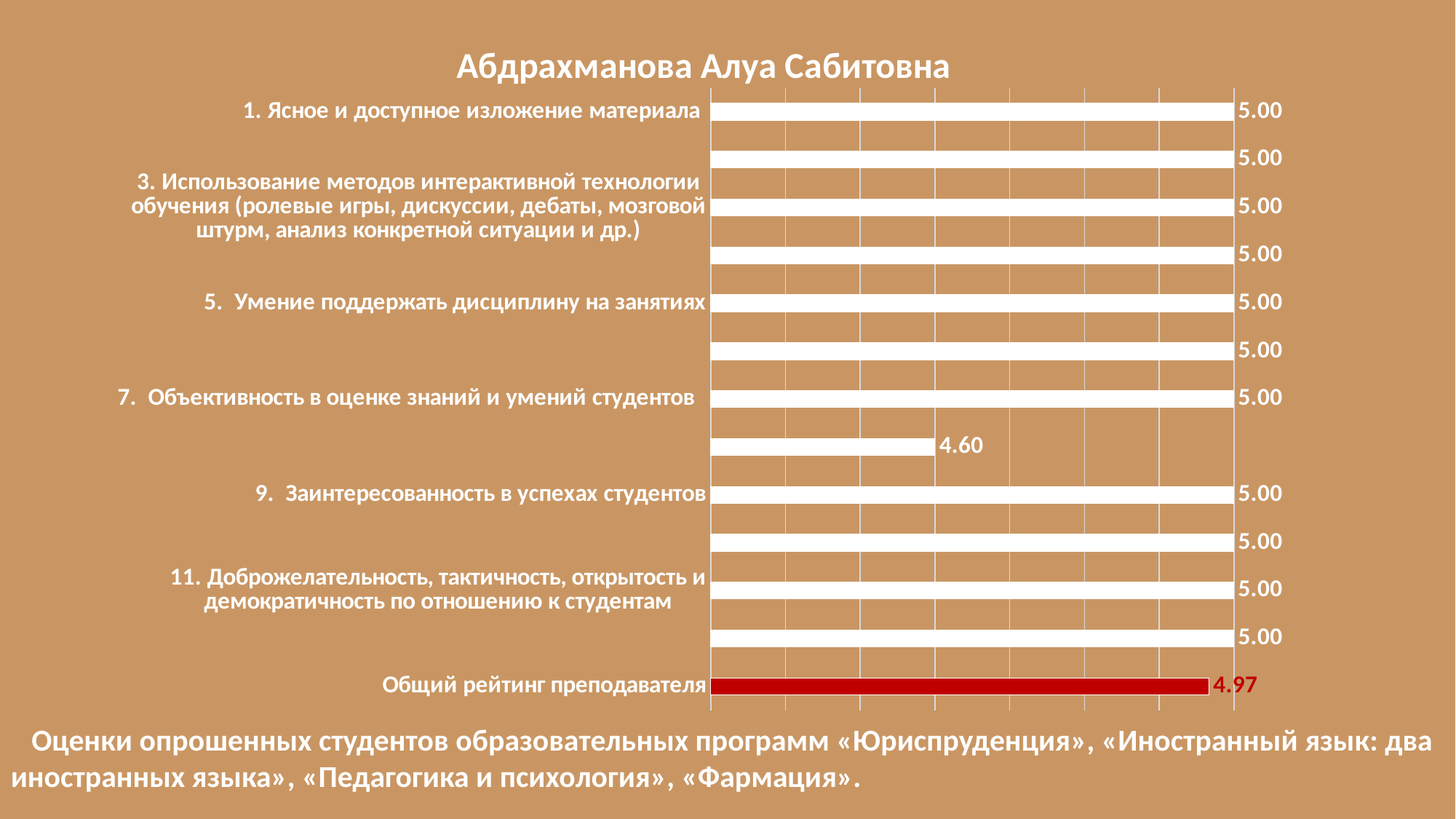
What is the value for "5. Умение поддержать дисциплину на занятиях"? 5.00 What is the title of the chart? Абдрахманова Алуа Сабитовна What is the difference between the value for "1. Ясное и доступное изложение материала" and the value for "Общий рейтинг преподавателя"? 0.03 What is the lowest value shown in the chart? 4.60 What is the value for "9. Заинтересованность в успехах студентов"? 5.00 What is the value for "11. Доброжелательность, тактичность, открытость и демократичность по отношению к студентам"? 5.00 What is the value for "1. Ясное и доступное изложение материала"? 5.00 What is the value for "Общий рейтинг преподавателя"? 4.97 How many bars are plotted in the chart? 13 Which is larger: the value for "7. Объективность в оценке знаний и умений студентов" or the value for "Общий рейтинг преподавателя"? 7. Объективность в оценке знаний и умений студентов What colour is the bar for "Общий рейтинг преподавателя"? red What kind of chart is shown on the slide? bar chart